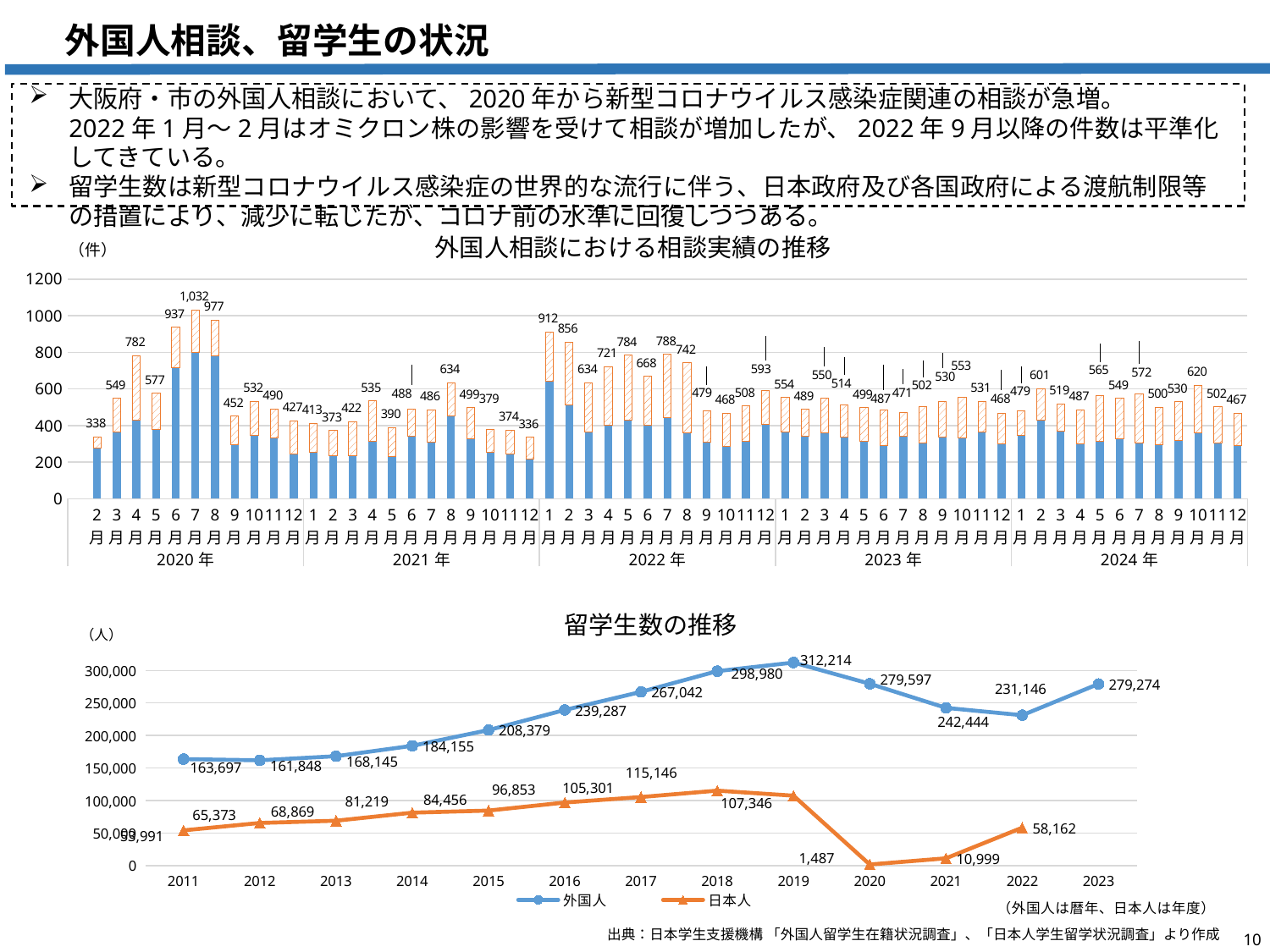
In the bottom chart 留学生数の推移, what kind of chart is shown? line chart In the top chart 外国人相談における相談実績の推移, which is larger, the total for 2020年7月 or 2020年8月? 2020年7月 In the top chart 外国人相談における相談実績の推移, which month has the highest total number of consultations? 2020年7月 In the top chart 外国人相談における相談実績の推移, what is the total value labeled for 2020年7月? 1,032 In the bottom chart 留学生数の推移, how many years are plotted on the x axis? 13 In the bottom chart 留学生数の推移, what is the 日本人 value for 2020? 1,487 In the bottom chart 留学生数の推移, in which year is the 外国人 value highest? 2019 In the bottom chart 留学生数の推移, what is the 外国人 value for 2023? 279,274 In the top chart 外国人相談における相談実績の推移, what is the difference between the totals for 2022年1月 and 2022年2月? 56 In the bottom chart 留学生数の推移, how many series does the legend list? 2 In the top chart 外国人相談における相談実績の推移, what is the total value labeled for 2022年1月? 912 In the bottom chart 留学生数の推移, what is the difference between the 外国人 values for 2019 and 2020? 32,617